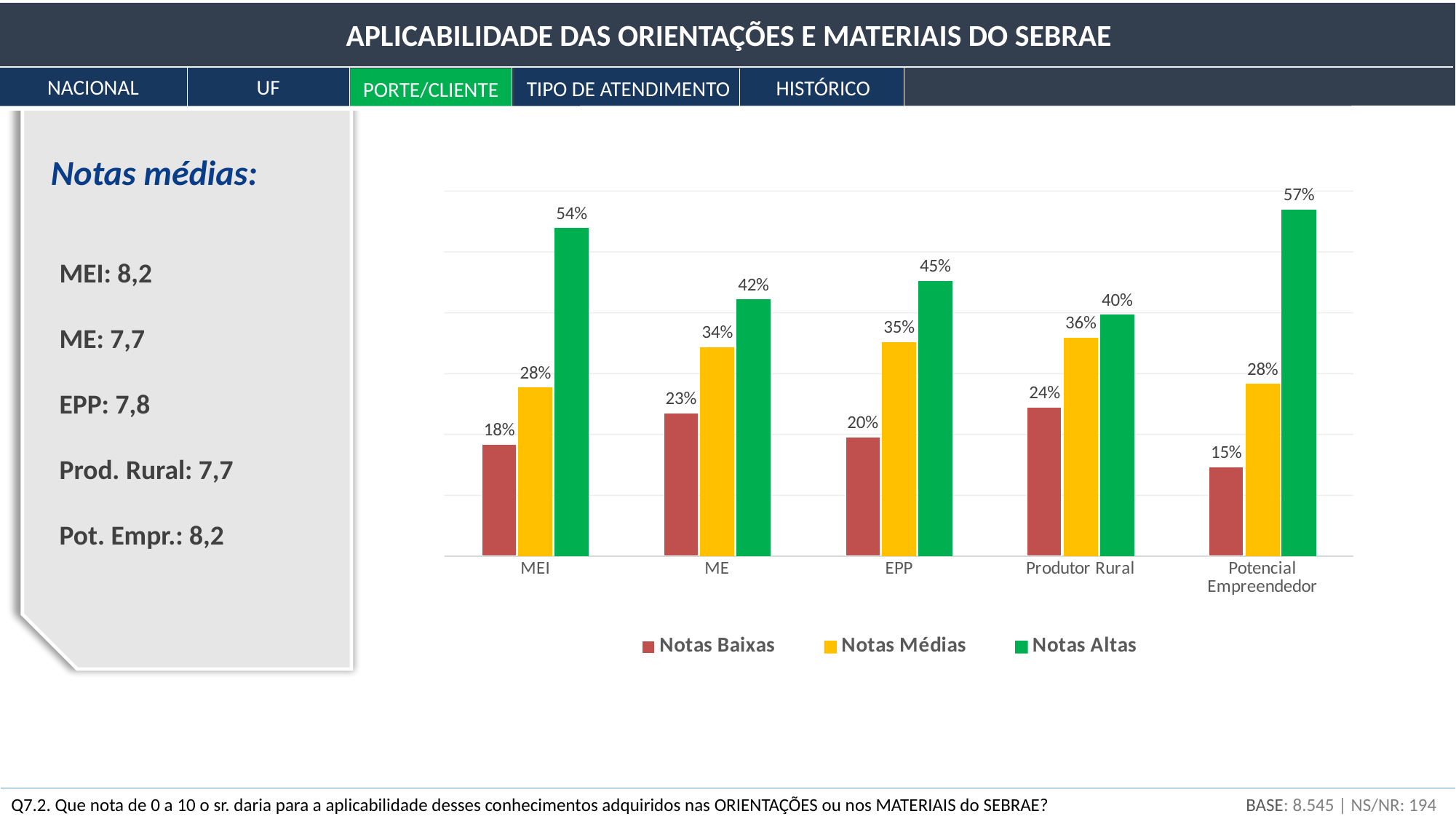
What is the value of Notas Médias for Produtor Rural? 36% What colour represents Notas Altas in the chart? Green What is the value of Notas Baixas for Potencial Empreendedor? 15% What is the difference between Notas Altas and Notas Baixas for EPP? 25% Which is larger for ME: Notas Médias or Notas Altas? Notas Altas How many categories are shown on the x axis? 5 Which category has the highest Notas Altas value? Potencial Empreendedor Which category has the lowest Notas Baixas value? Potencial Empreendedor How many series does the legend list? 3 What kind of chart is shown? Bar chart What is the value of Notas Altas for MEI? 54% What is the difference in Notas Altas between Potencial Empreendedor and Produtor Rural? 17%